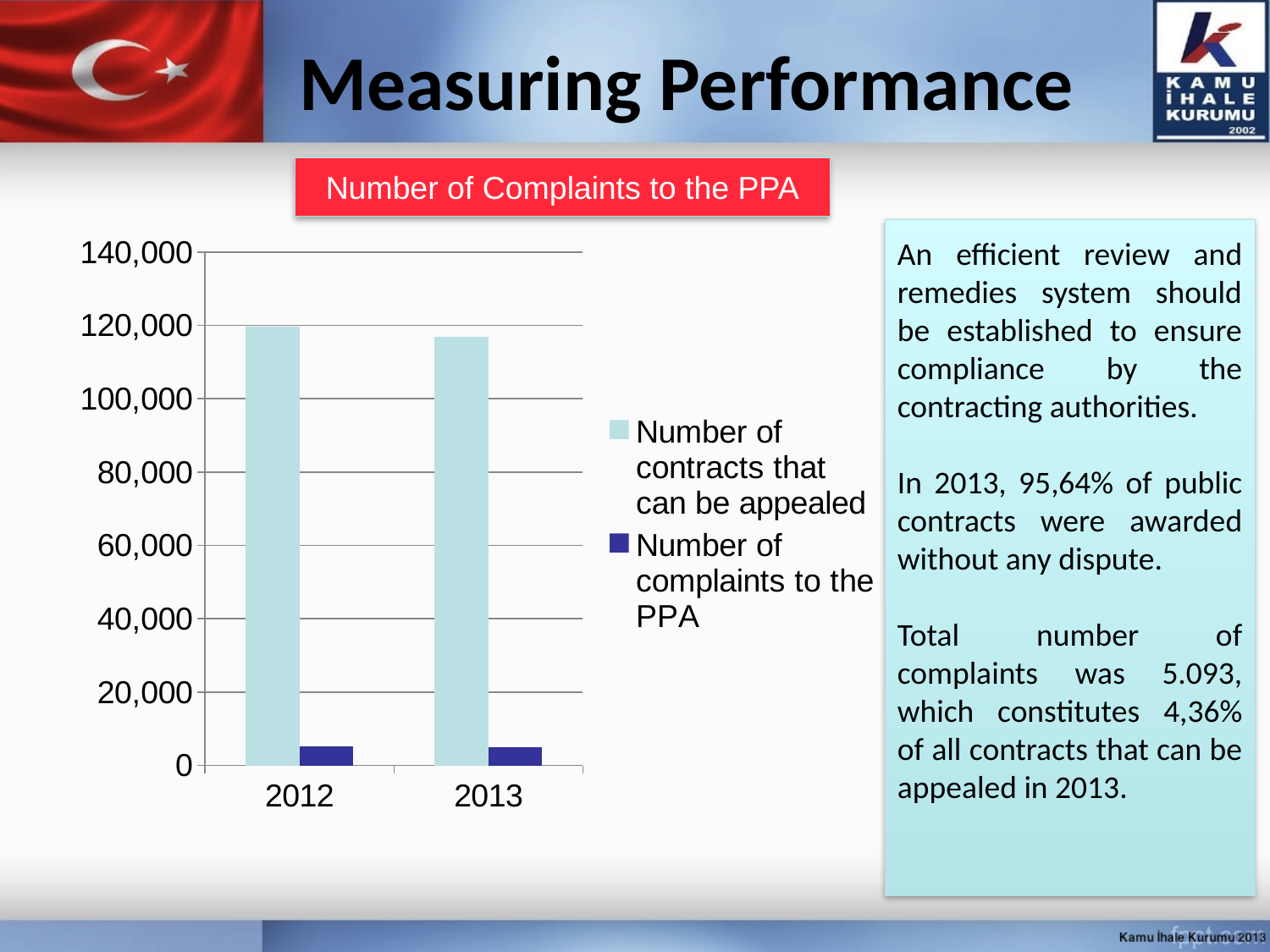
How many series does the legend of the chart list? 2 Is the value for 'Number of complaints to the PPA' in 2012 greater or less than 40,000? less Is the value for 'Number of contracts that can be appealed' in 2012 greater or less than 100,000? greater What is the highest value shown on the y axis of the chart? 140,000 Is the value for 'Number of contracts that can be appealed' in 2013 greater or less than 120,000? less In 2013, which series has the larger value: 'Number of contracts that can be appealed' or 'Number of complaints to the PPA'? Number of contracts that can be appealed What kind of chart is shown under the title 'Number of Complaints to the PPA'? bar chart How many years are shown on the x axis of the chart? 2 What is the title of the chart? Number of Complaints to the PPA Which years are shown on the x axis of the chart? 2012 and 2013 For 'Number of contracts that can be appealed', which year has the higher value, 2012 or 2013? 2012